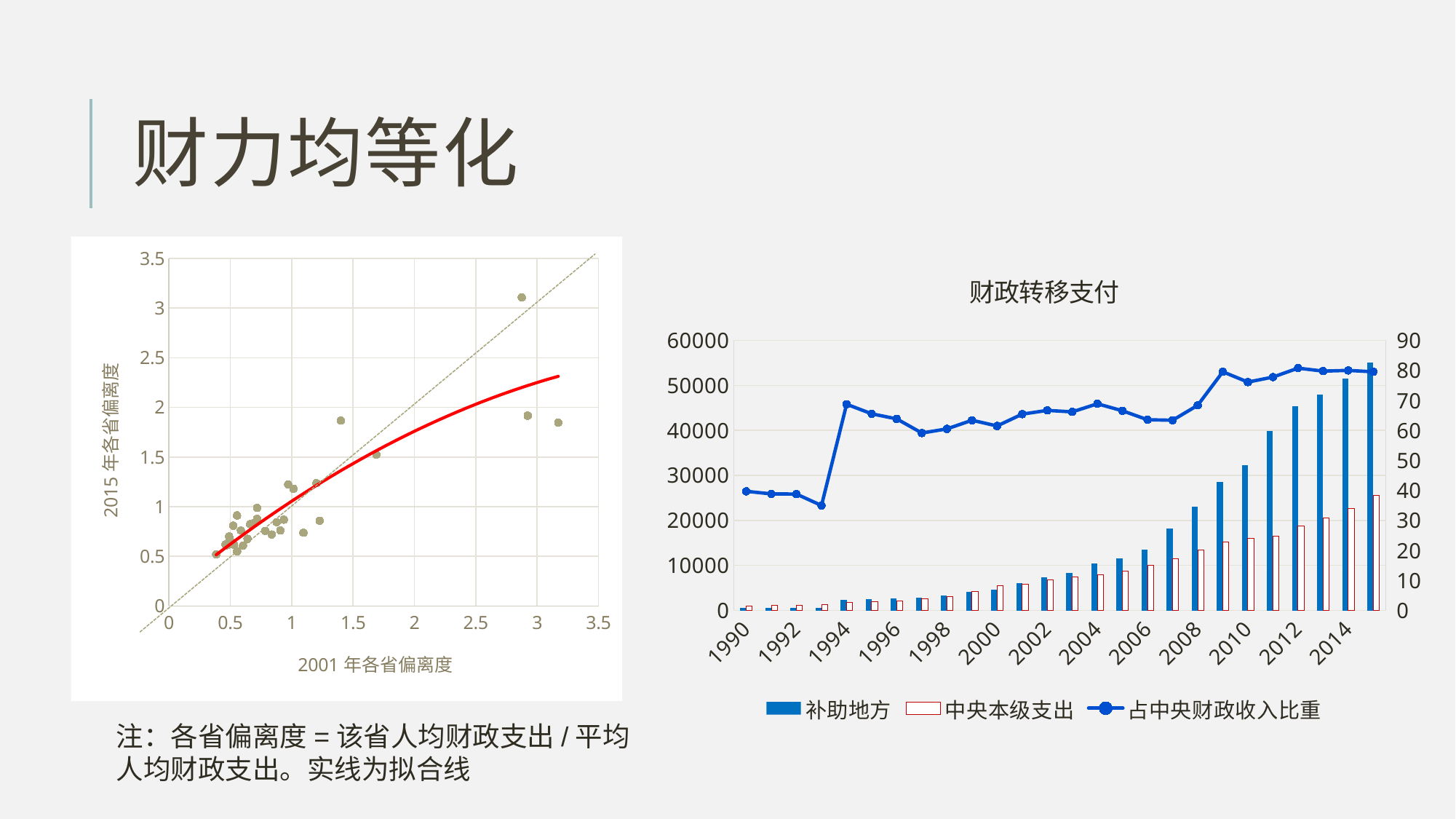
In the chart titled 财政转移支付, is the 补助地方 value for 2010 greater or less than 30000? greater In the chart titled 财政转移支付, is the 补助地方 value for 2015 greater or less than 50000? greater In the scatter chart on the left, what is the label of the x axis? 2001 年各省偏离度 What is the title of the chart on the right of the slide? 财政转移支付 In the chart titled 财政转移支付, is the 占中央财政收入比重 value for 1993 greater or less than 40? less In the chart titled 财政转移支付, do the 补助地方 bars generally rise or fall from 1990 to 2015? rise In the chart titled 财政转移支付, which is larger in 2015, 补助地方 or 中央本级支出? 补助地方 What kind of chart is the chart on the left of the slide? scatter chart In the chart titled 财政转移支付, how many series does the legend list? 3 In the chart titled 财政转移支付, which series is drawn as a line with markers? 占中央财政收入比重 In the chart titled 财政转移支付, in which year is the 补助地方 bar highest? 2015